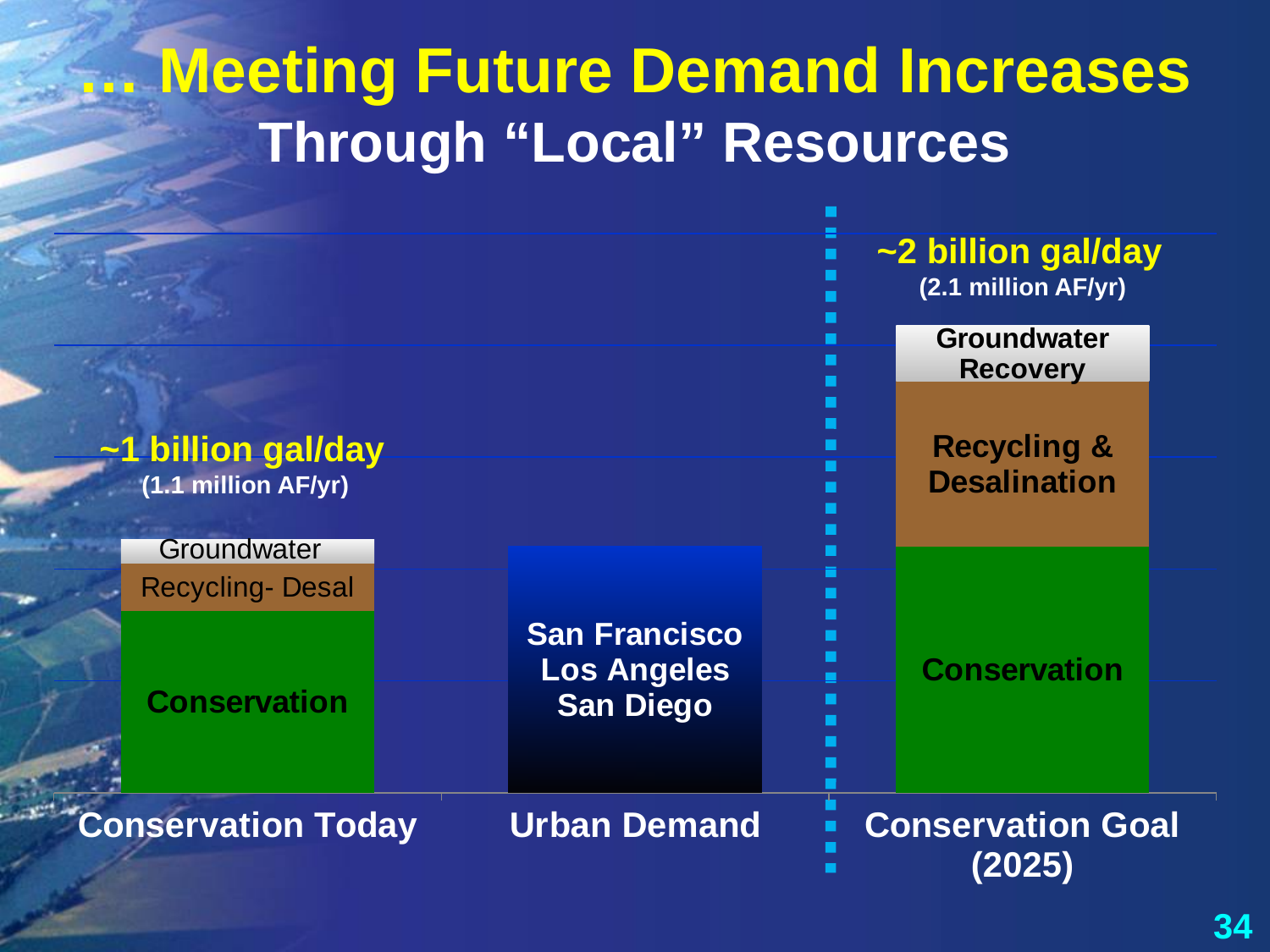
How many bars (categories) are shown along the x axis? 3 What kind of chart is shown on the slide? Stacked bar chart Which is taller, the Conservation Goal (2025) bar or the Urban Demand bar? Conservation Goal (2025) What annual volume in AF/yr is given for the Conservation Goal (2025)? 2.1 million AF/yr Which is taller, the Urban Demand bar or the Conservation Today bar? Conservation Today Which segment is at the bottom of the Conservation Today bar? Conservation How many segments make up the Conservation Goal (2025) bar? 3 Which three cities are named inside the Urban Demand bar? San Francisco, Los Angeles, San Diego What annual volume in AF/yr is given for Conservation Today? 1.1 million AF/yr Which bar is the shortest? Urban Demand Which bar is the tallest? Conservation Goal (2025)